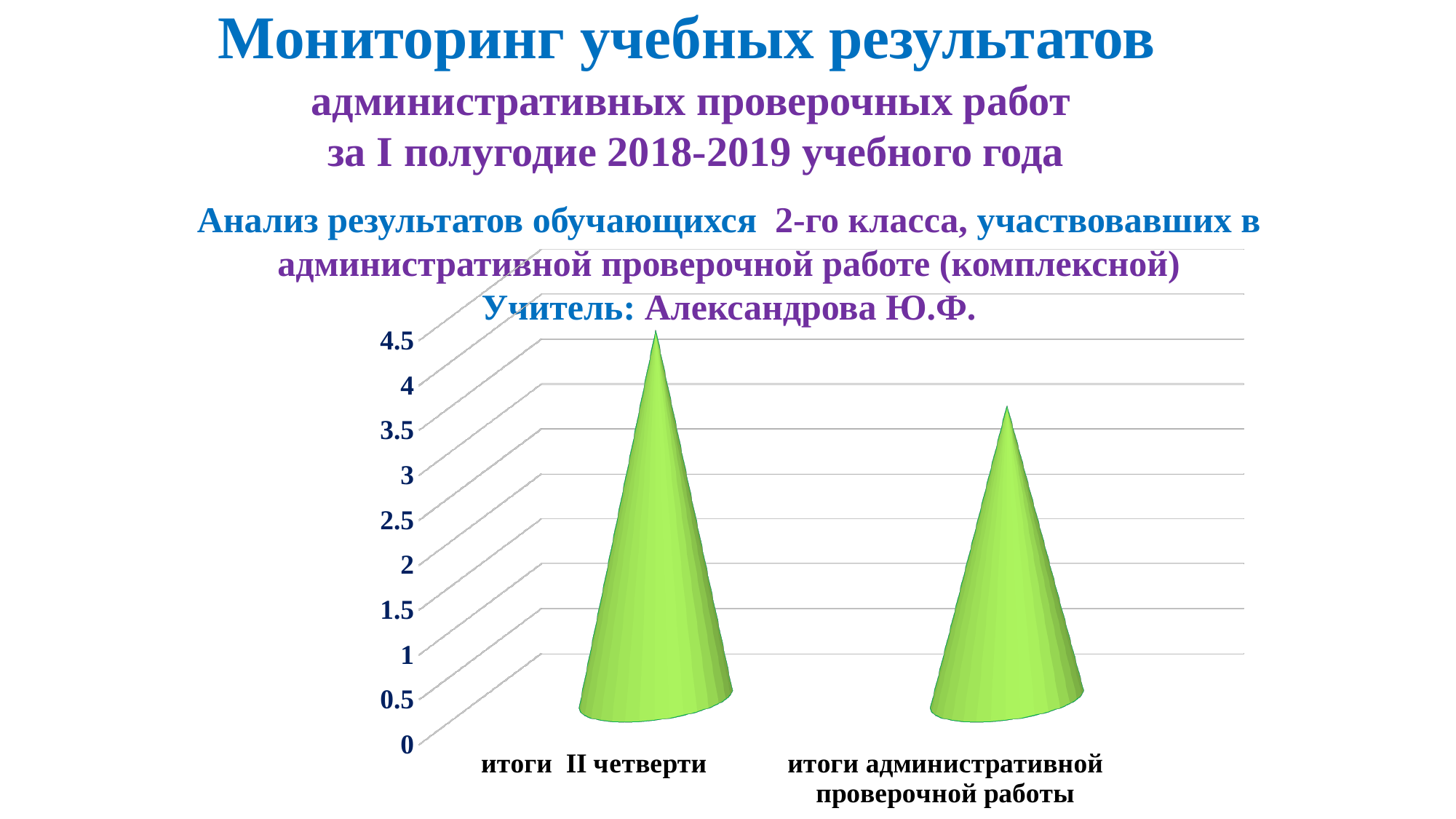
Do the values rise or fall from the first category to the second along the x axis? fall Is the value for итоги административной проверочной работы greater or less than 3? greater Is the value for итоги II четверти greater or less than 3.5? greater How many categories are plotted on the chart? 2 Which category has the lowest value? итоги административной проверочной работы Is the value for итоги административной проверочной работы greater or less than 4? less What kind of chart is shown on the slide? bar chart Which category has the highest value? итоги II четверти What is the highest tick label shown on the vertical axis? 4.5 Which is larger: the value for итоги II четверти or the value for итоги административной проверочной работы? итоги II четверти What colour are the bars on the chart? green